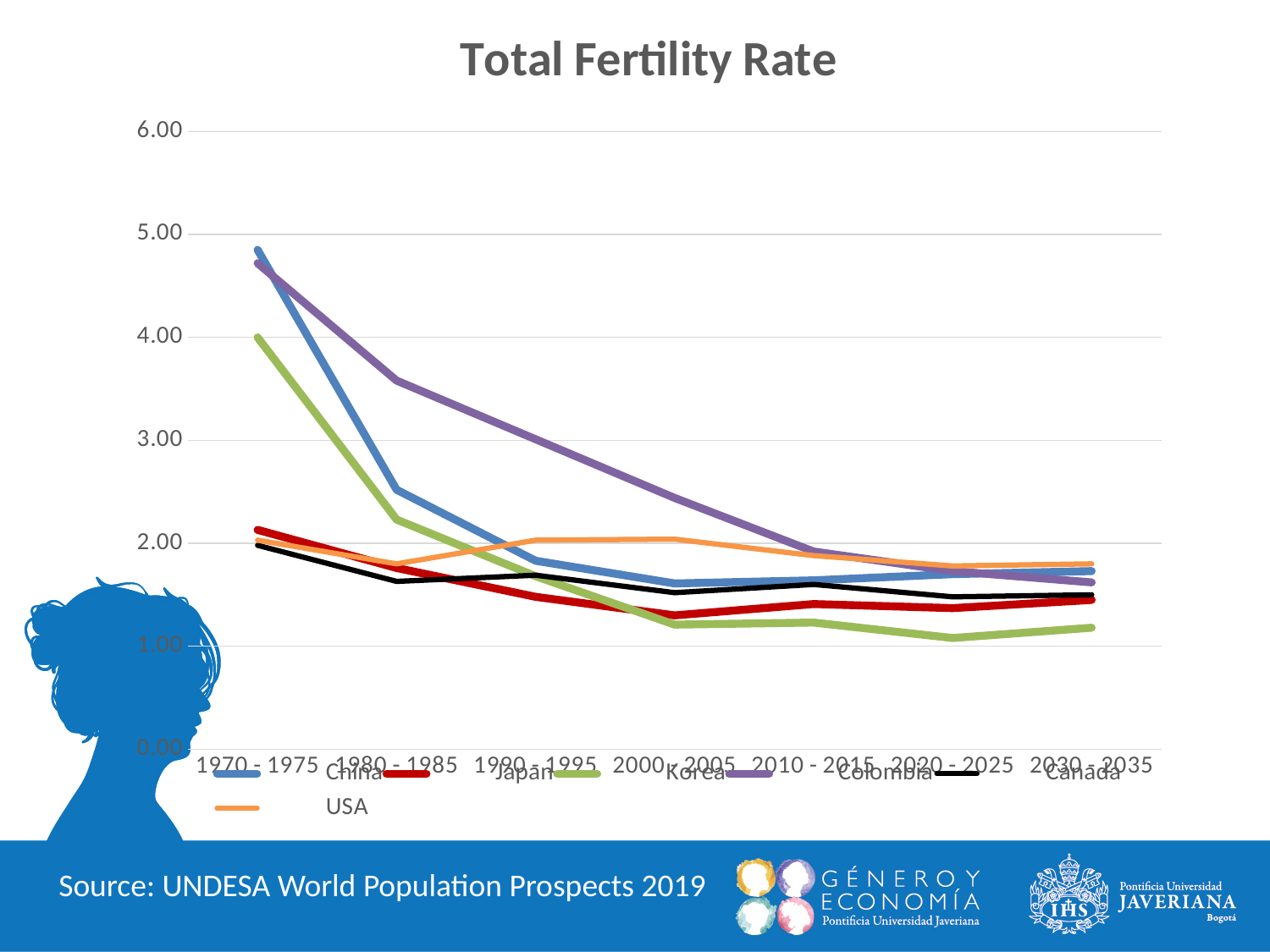
How many series does the legend list? 6 Is the value for Japan in 2000 - 2005 greater or less than 2.00? less Does the total fertility rate for Colombia rise or fall from 1970 - 1975 to 2030 - 2035? Fall What source is cited for the chart data? UNDESA World Population Prospects 2019 How many time periods are shown along the x axis? 7 What kind of chart is shown on the slide? Line chart Which country has the highest total fertility rate in 2000 - 2005? Colombia In 2030 - 2035, which is larger, the value for Japan or the value for Korea? Japan Is the value for China in 1980 - 1985 greater or less than 2.00? greater Which country has the lowest total fertility rate in 2020 - 2025? Korea Is the value for Korea in 1970 - 1975 greater or less than 3.00? greater What is the title of the chart? Total Fertility Rate